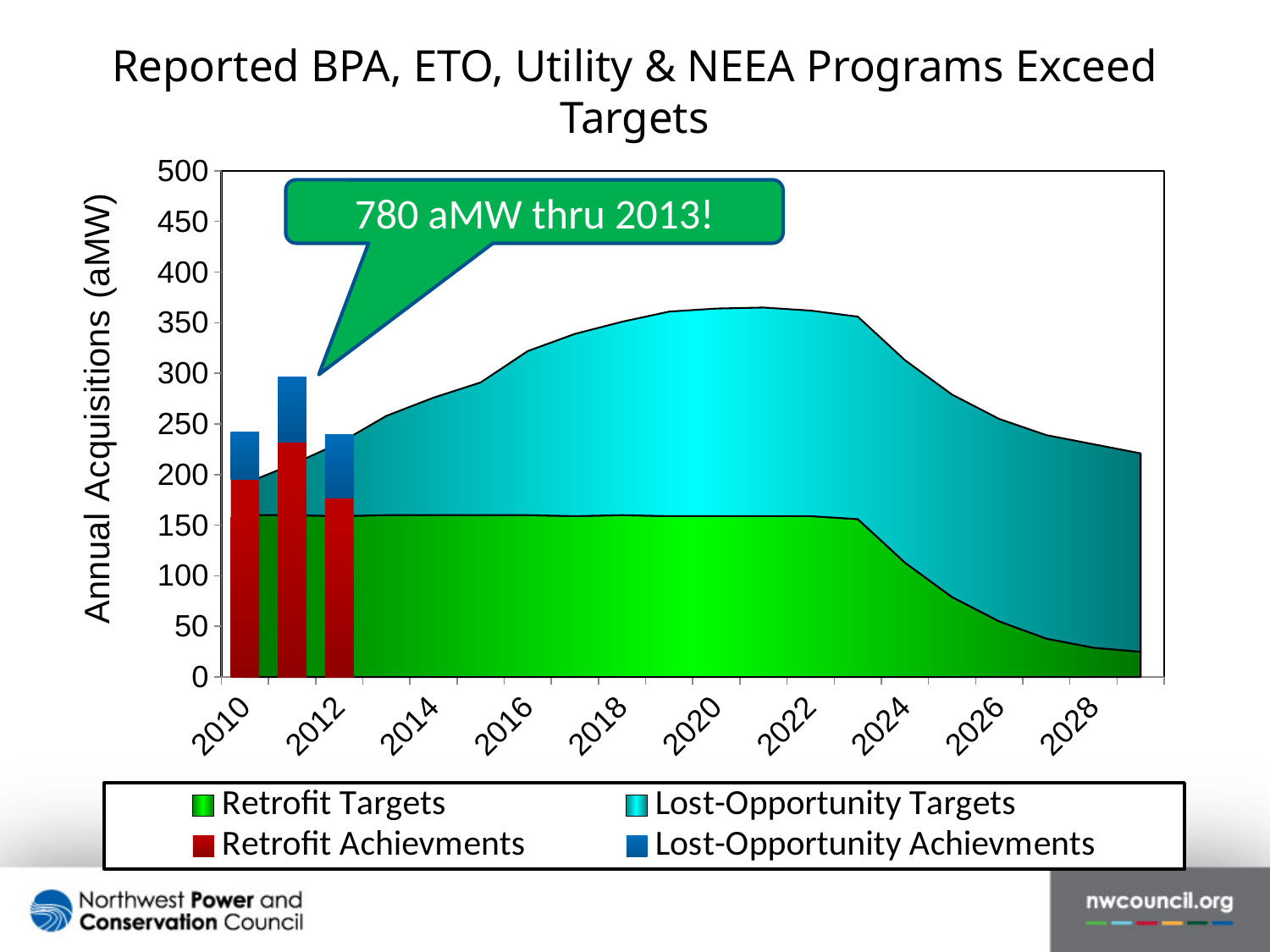
Is the Retrofit Achievements value for 2011 greater or less than 200? greater Do the combined targets rise or fall from 2024 to 2028? fall Is the Retrofit Targets value in 2028 greater or less than 50? less What does the callout on the chart say? 780 aMW thru 2013! How many series does the legend list? 4 How many years have achievement bars plotted? 3 Which is larger, the Retrofit Achievements value for 2010 or for 2011? 2011 What is the title of the slide's chart? Reported BPA, ETO, Utility & NEEA Programs Exceed Targets Is the Retrofit Achievements value for 2010 greater or less than 150? greater Which year has the tallest stacked achievements bar? 2011